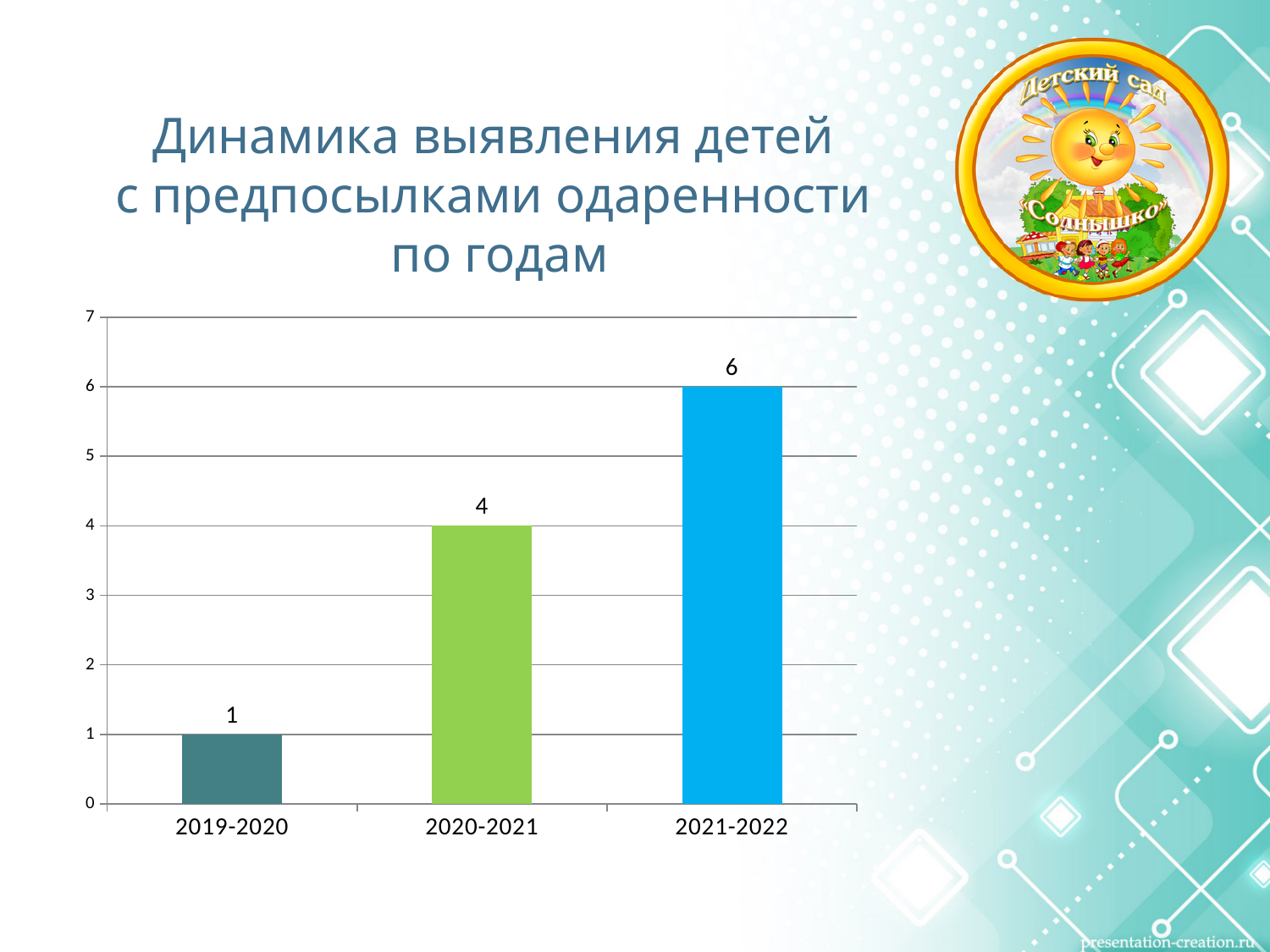
What is the value for 2021-2022? 6 What is the difference between the values for 2021-2022 and 2019-2020? 5 What is the difference between the values for 2021-2022 and 2020-2021? 2 What is the value for 2020-2021? 4 Do the values rise or fall from 2019-2020 to 2021-2022? rise Which year has the highest value? 2021-2022 Is the value for 2021-2022 greater or less than 5? greater Which year has the lowest value? 2019-2020 How many years are shown on the chart? 3 What is the value for 2019-2020? 1 Which is larger, the value for 2020-2021 or the value for 2019-2020? 2020-2021 What kind of chart is shown on the slide? bar chart